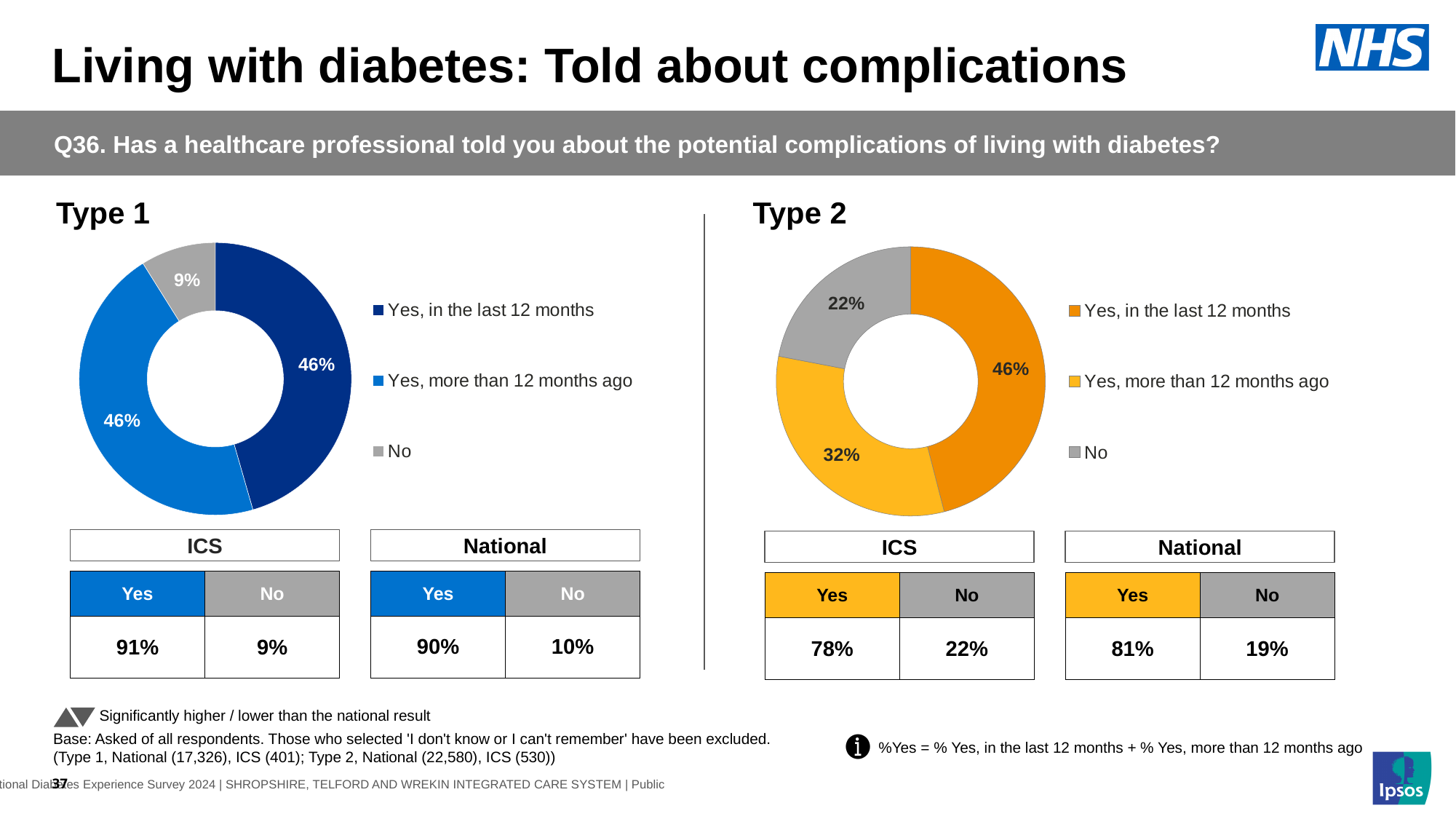
In the Type 1 chart, which category has the smallest share? No How many categories does the legend of the Type 1 chart list? 3 What is the difference between the Type 1 'No' share and the Type 2 'No' share? 13 percentage points In the Type 2 chart, what is the difference between the 'Yes, in the last 12 months' share and the 'Yes, more than 12 months ago' share? 14 percentage points What colour represents 'No' in the Type 2 chart? Grey In the Type 1 chart, what percentage of respondents answered 'No'? 9% In the Type 2 chart, which category has the largest share? Yes, in the last 12 months What kind of chart is used for Type 1? Doughnut (pie) chart In the Type 2 chart, what percentage of respondents answered 'Yes, more than 12 months ago'? 32% In the Type 2 chart, is the 'No' share larger or smaller than the 'Yes, more than 12 months ago' share? smaller In the Type 2 chart, which category has the smallest share? No In the Type 2 chart, what percentage of respondents answered 'Yes, in the last 12 months'? 46%